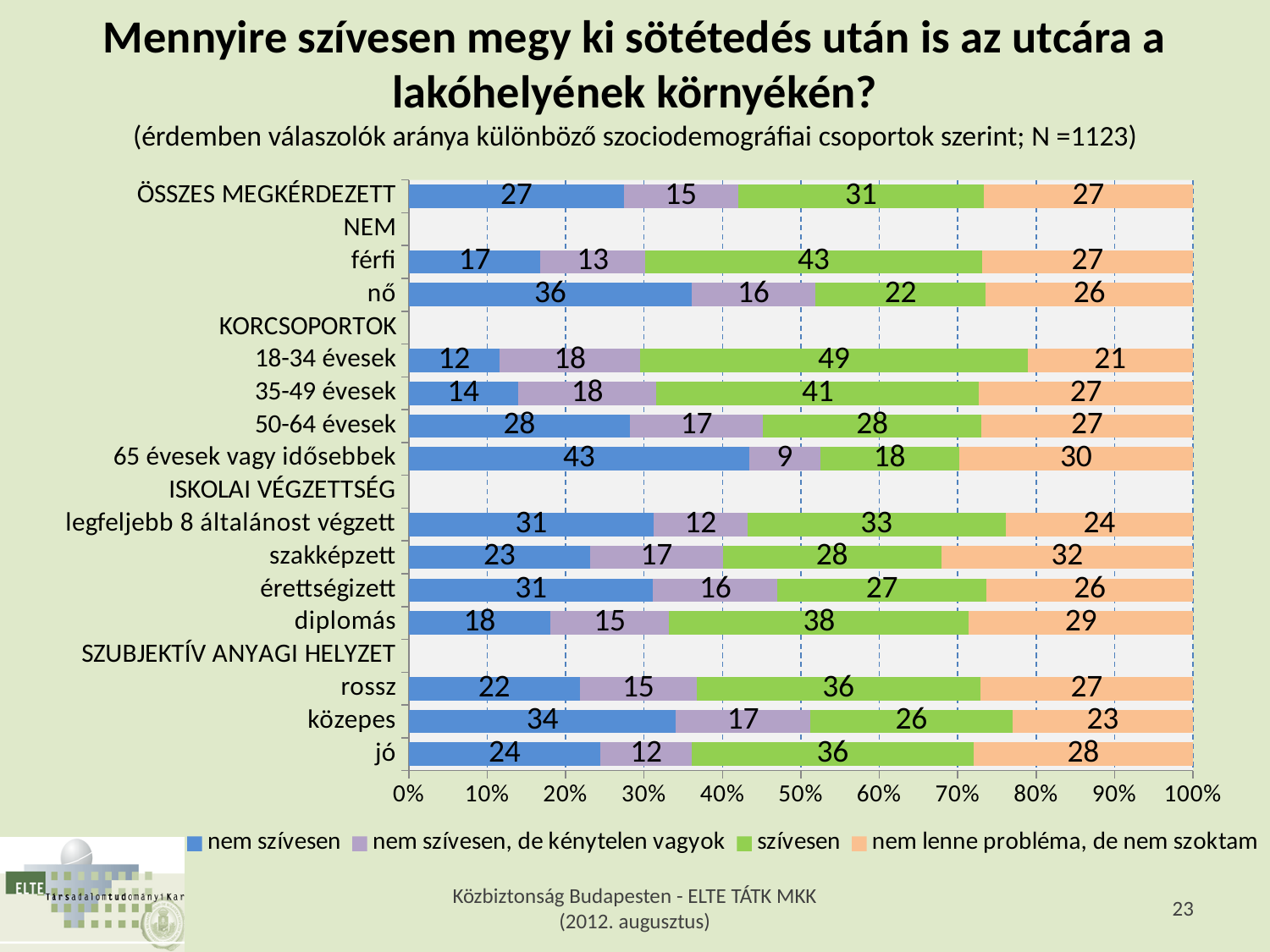
Which group has the highest value for the 'nem szívesen' series? 65 évesek vagy idősebbek What is the total of the stacked bar for 'ÖSSZES MEGKÉRDEZETT'? 100 What is the value of the 'nem szívesen' series for '65 évesek vagy idősebbek'? 43 What kind of chart is shown on the slide? stacked bar chart What is the value of the 'szívesen' series for the '18-34 évesek' group? 49 Which group has the lowest value for the 'nem szívesen' series? 18-34 évesek How many series does the legend list? 4 How many groups have a plotted bar in the chart? 14 What is the value of 'nem lenne probléma, de nem szoktam' for the 'szakképzett' group? 32 Which has a larger 'szívesen' value, 'férfi' or 'nő'? férfi Which series is shown in green in the legend? szívesen What is the difference between the 'nem szívesen' values for 'nő' and 'férfi'? 19